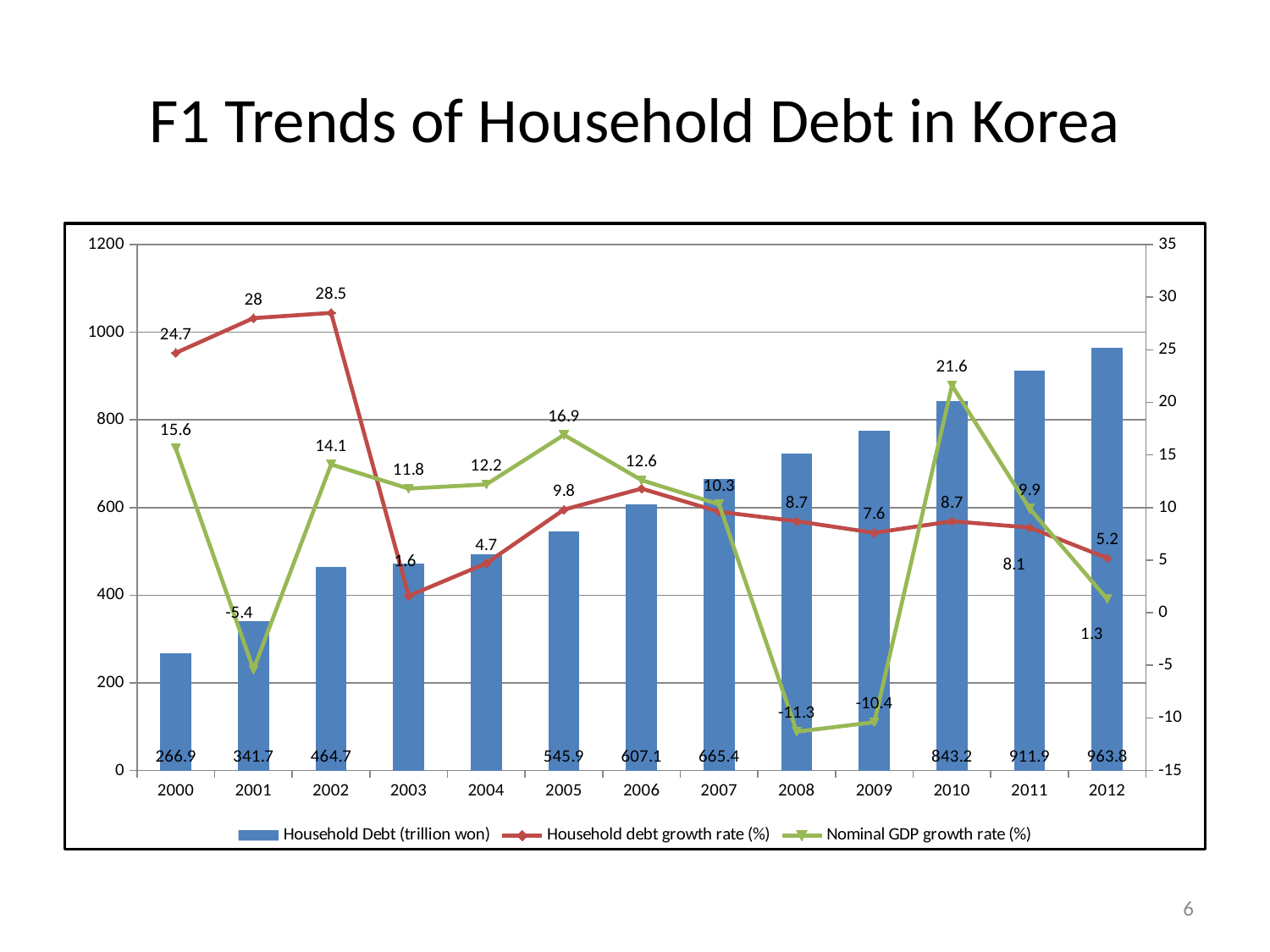
Do the Household Debt (trillion won) bars rise or fall from 2000 to 2012? rise What is the Nominal GDP growth rate (%) for 2001? -5.4 Is the Household Debt (trillion won) value for 2008 greater or less than 600? greater What is the Household debt growth rate (%) for 2002? 28.5 Which is larger, the Household debt growth rate (%) in 2000 or in 2012? 2000 What is the Household Debt (trillion won) value for 2012? 963.8 How many series does the legend list? 3 What is the difference in Household Debt (trillion won) between 2012 and 2011? 51.9 Which year has the lowest Household Debt (trillion won)? 2000 Which year has the lowest Nominal GDP growth rate (%)? 2008 How many years are shown on the x axis? 13 Which year has the highest Nominal GDP growth rate (%)? 2010